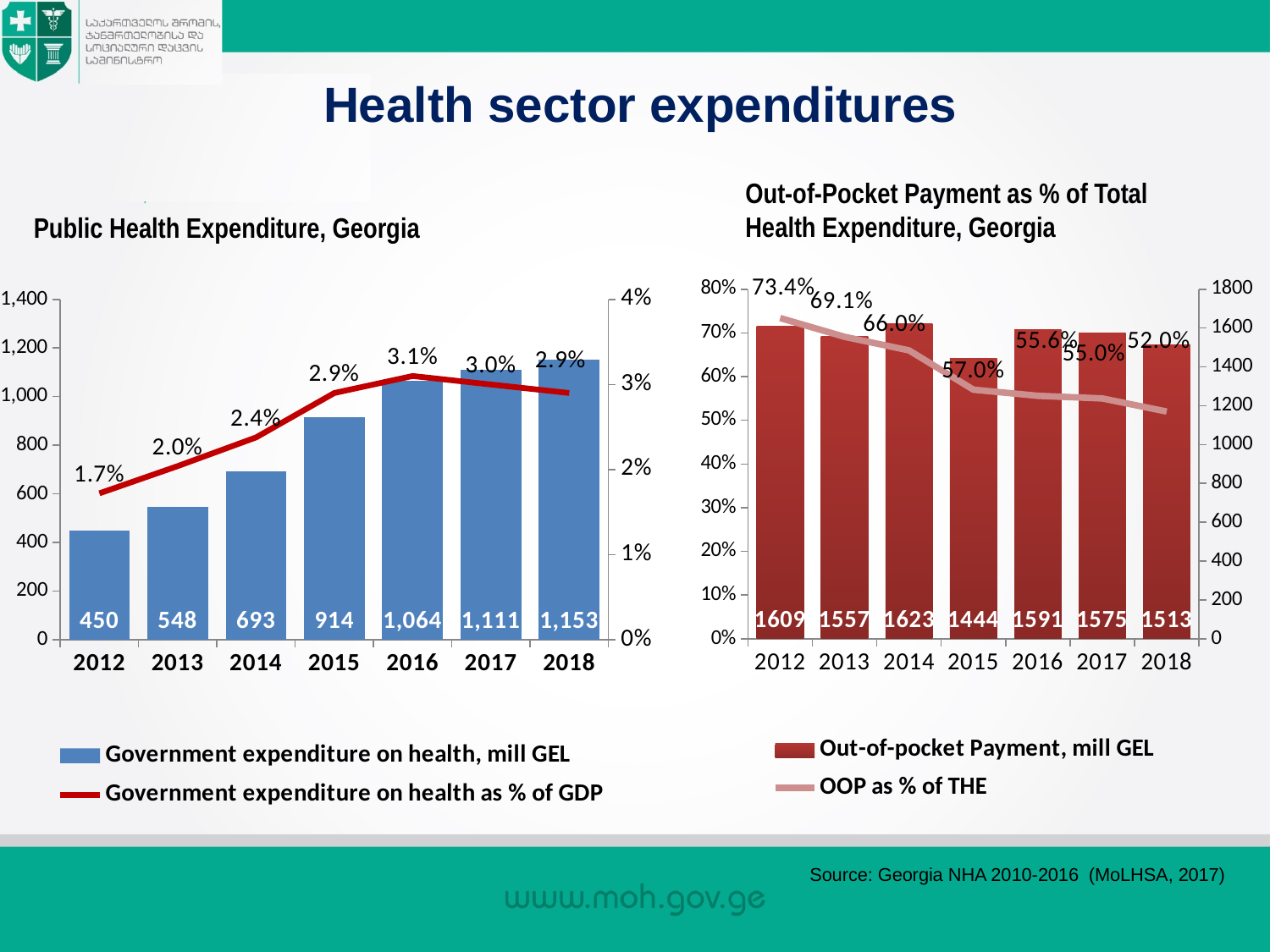
In the 'Public Health Expenditure, Georgia' chart, which year had the lowest government expenditure on health in mill GEL? 2012 In the 'Public Health Expenditure, Georgia' chart, what was government expenditure on health as % of GDP in 2016? 3.1% In the 'Out-of-Pocket Payment as % of Total Health Expenditure, Georgia' chart, does OOP as % of THE rise or fall from 2012 to 2018? fall In the 'Public Health Expenditure, Georgia' chart, how many series does the legend list? 2 In the 'Out-of-Pocket Payment as % of Total Health Expenditure, Georgia' chart, which year had the highest out-of-pocket payment in mill GEL? 2014 In the 'Out-of-Pocket Payment as % of Total Health Expenditure, Georgia' chart, what was OOP as % of THE in 2012? 73.4% In the 'Public Health Expenditure, Georgia' chart, what was government expenditure on health in mill GEL in 2015? 914 How many years are shown on the x axis of the 'Public Health Expenditure, Georgia' chart? 7 In the 'Out-of-Pocket Payment as % of Total Health Expenditure, Georgia' chart, what was the out-of-pocket payment in mill GEL in 2015? 1444 In the 'Public Health Expenditure, Georgia' chart, by how much did government expenditure on health in mill GEL increase from 2012 to 2018? 703 In the 'Public Health Expenditure, Georgia' chart, does government expenditure on health in mill GEL rise or fall from 2012 to 2018? rise In the 'Out-of-Pocket Payment as % of Total Health Expenditure, Georgia' chart, which is larger: out-of-pocket payment in mill GEL in 2016 or in 2018? 2016